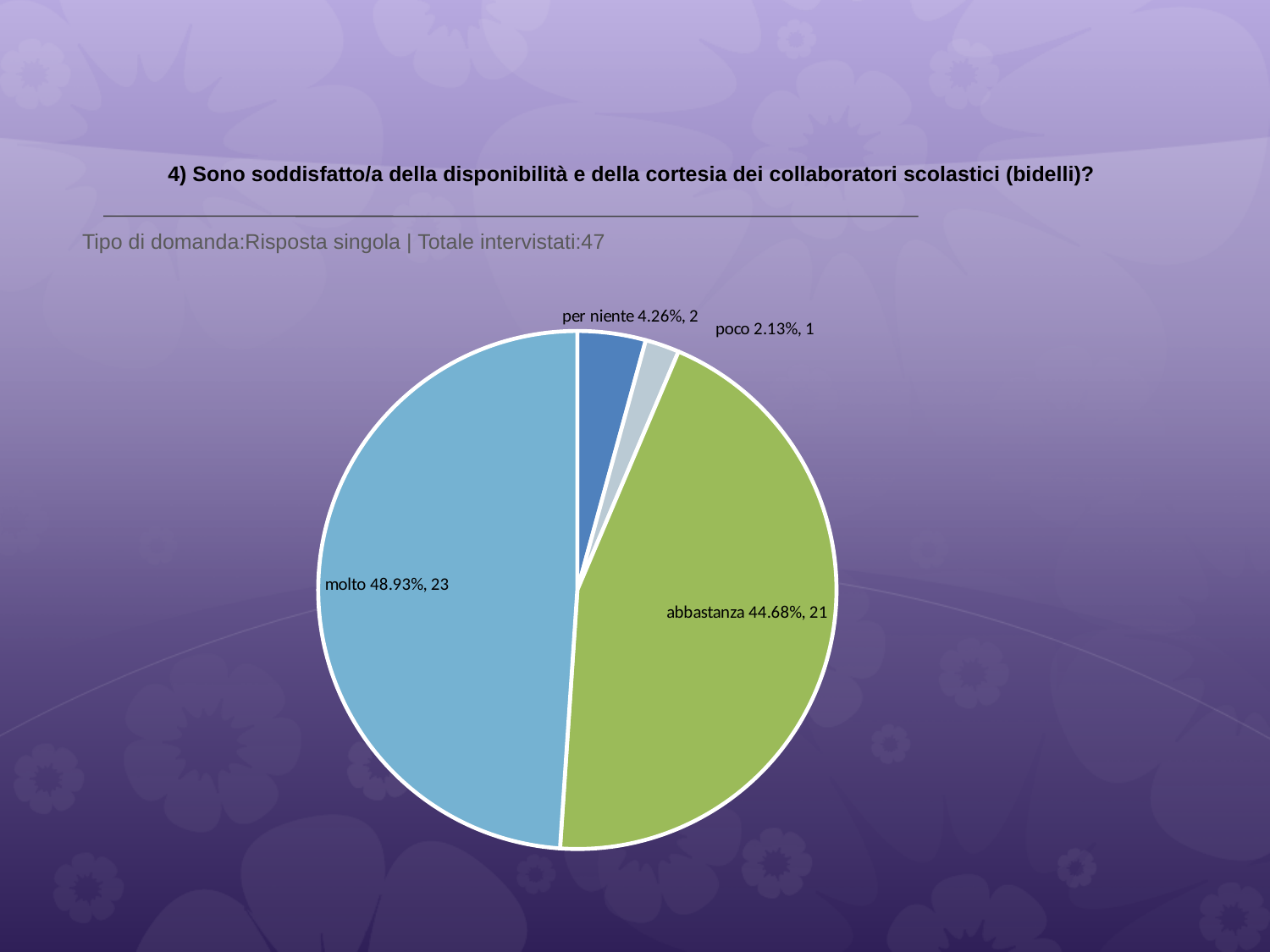
What is the total number of respondents stated on the slide? 47 How many slices does the pie chart have? 4 What percentage share does the 'molto' slice have? 48.93% How many respondents answered 'poco'? 1 Which category has the largest slice? molto How many respondents answered 'molto'? 23 How many respondents answered 'per niente'? 2 Which category has the smallest slice? poco What percentage share does the 'abbastanza' slice have? 44.68% What is the difference in respondent count between 'molto' and 'abbastanza'? 2 What kind of chart is shown on the slide? pie chart Which has more respondents, 'per niente' or 'poco'? per niente